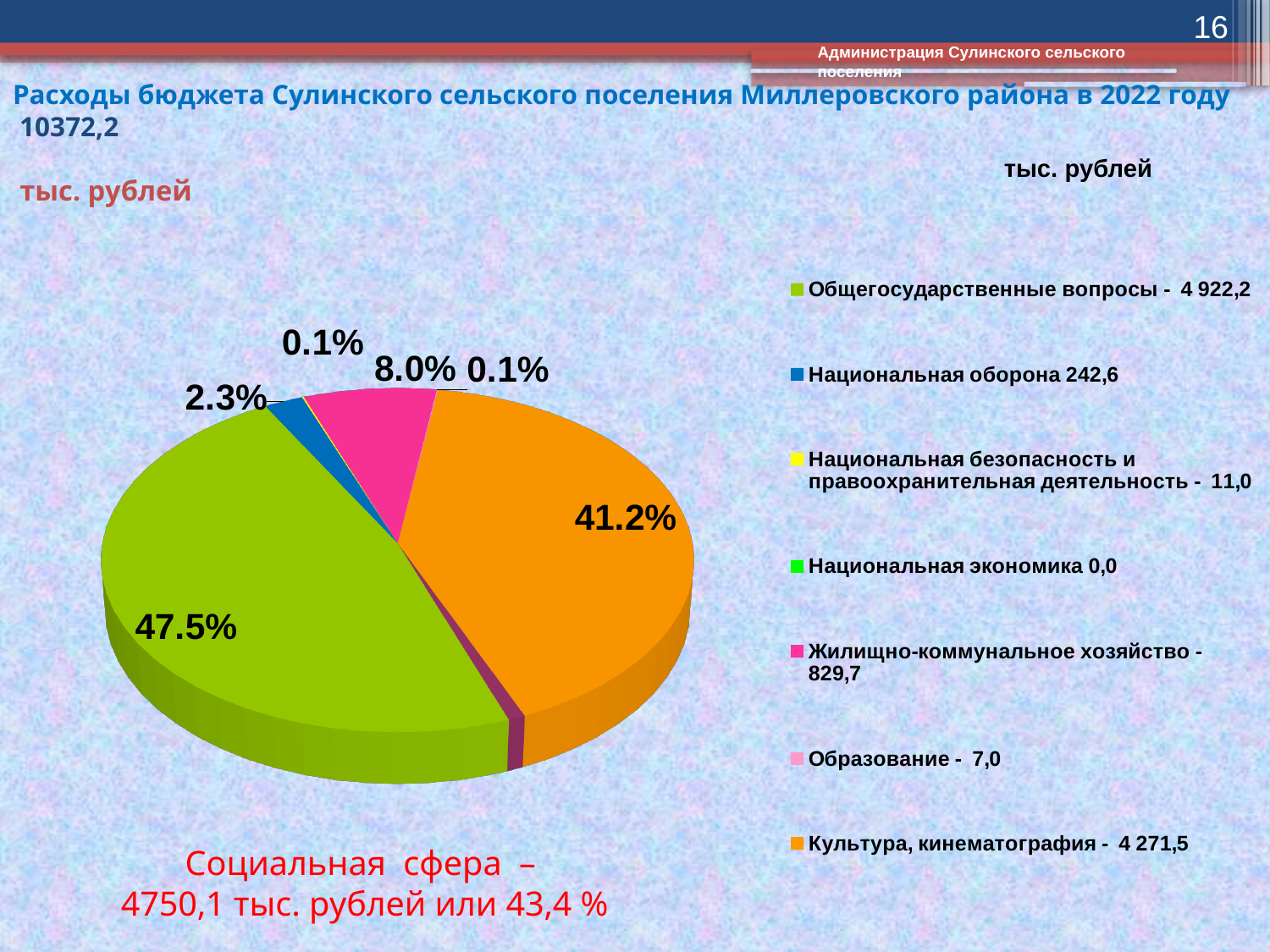
What share of the pie does the Культура, кинематография slice have? 41.2% Which category has the largest share of the pie? Общегосударственные вопросы How many entries does the legend list? 7 What share of the pie does the Общегосударственные вопросы slice have? 47.5% What is the difference in percentage points between the Общегосударственные вопросы share and the Культура, кинематография share? 6.3 What share of the pie does the Национальная оборона slice have? 2.3% Which is larger, the share for Жилищно-коммунальное хозяйство or the share for Национальная оборона? Жилищно-коммунальное хозяйство What value does the legend give for Жилищно-коммунальное хозяйство? 829,7 What value does the legend give for Национальная оборона? 242,6 What kind of chart is shown on the slide? pie chart What value does the legend give for Культура, кинематография? 4 271,5